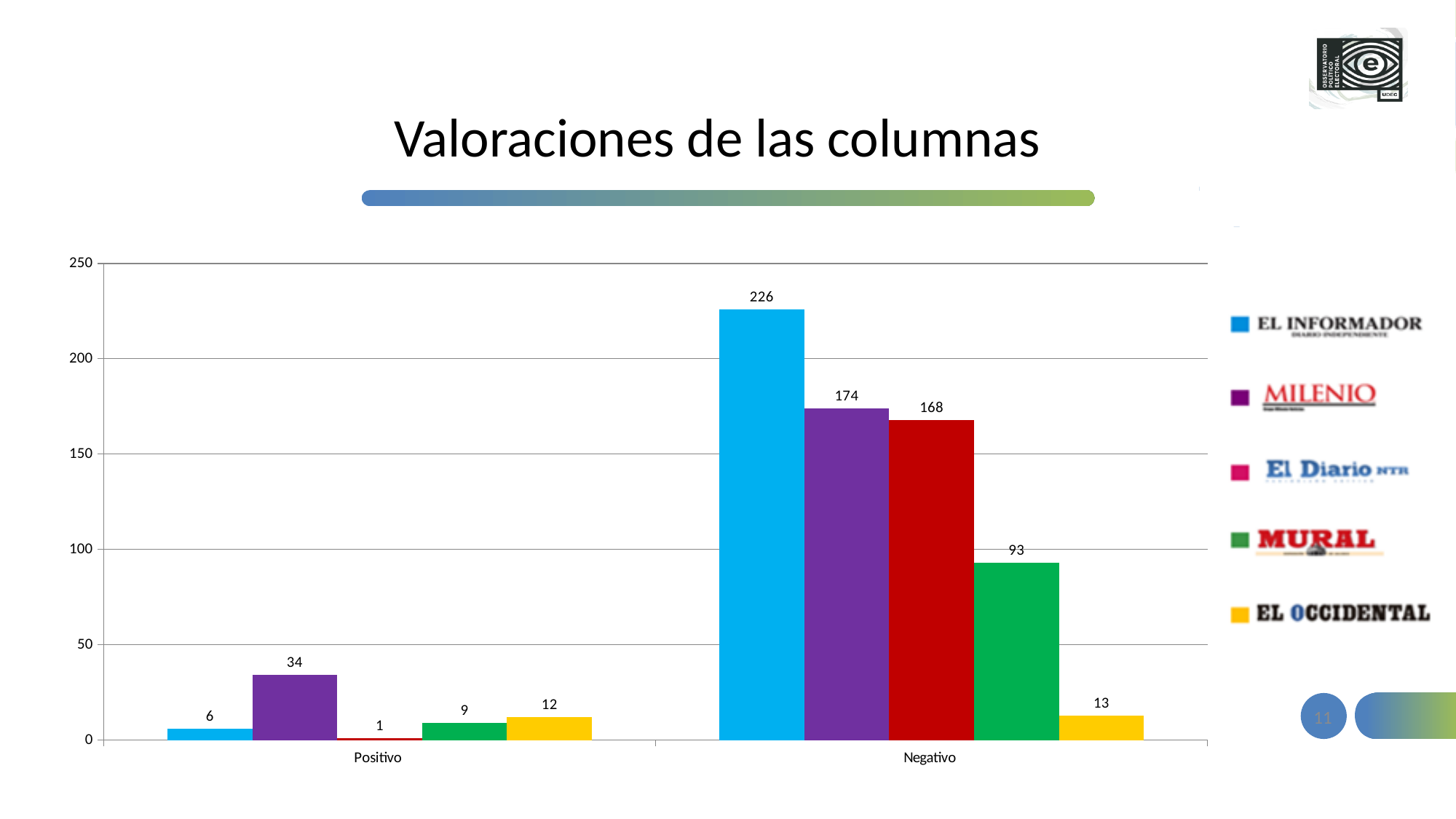
What is the difference between the Negativo values for Milenio and El Diario NTR? 6 How many categories are shown on the x axis? 2 Which newspaper has the highest Negativo value? El Informador Which newspaper has the lowest Positivo value? El Diario NTR What is the Positivo value for Milenio? 34 What is the Negativo value for Mural? 93 What kind of chart is shown on the slide? Bar chart What is the Negativo value for El Informador? 226 What is the Positivo value for El Diario NTR? 1 How many series does the legend list? 5 Which is larger, the Positivo value for El Occidental or the Positivo value for Mural? El Occidental What is the title of the slide? Valoraciones de las columnas